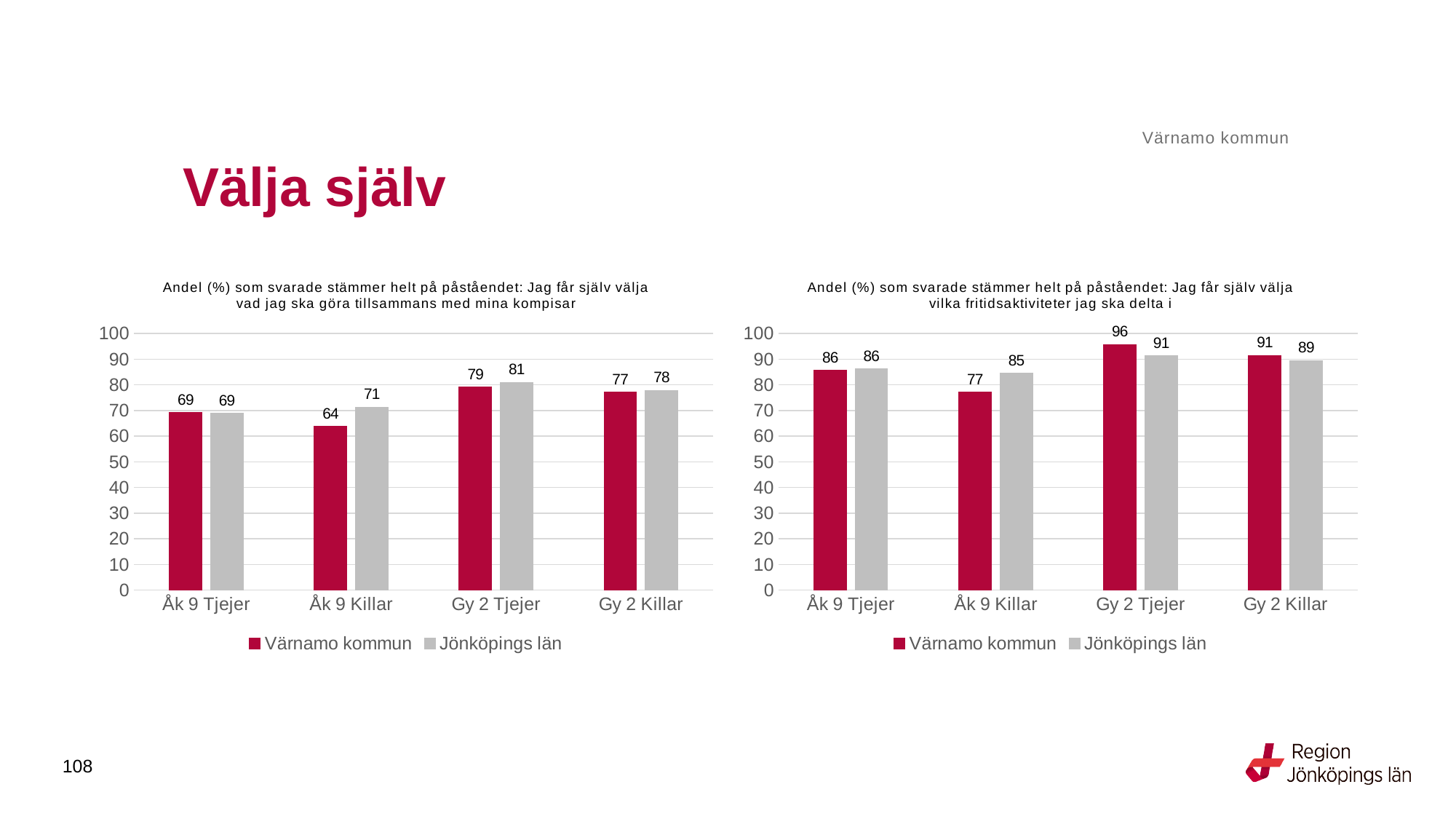
In the left chart (about choosing what to do with friends), what is the value for Jönköpings län for Gy 2 Tjejer? 81 In the left chart (about choosing what to do with friends), what is the value for Värnamo kommun for Åk 9 Killar? 64 What kind of chart is the left chart? Bar chart How many series does the legend of the right chart list? 2 In the right chart (about choosing leisure activities), what is the value for Värnamo kommun for Gy 2 Tjejer? 96 In the left chart (about choosing what to do with friends), which category has the lowest value for Värnamo kommun? Åk 9 Killar How many categories are shown on the x axis of the left chart? 4 In the right chart (about choosing leisure activities), what is the value for Jönköpings län for Åk 9 Killar? 85 In the right chart (about choosing leisure activities), which category has the highest value for Värnamo kommun? Gy 2 Tjejer In the right chart (about choosing leisure activities), which is larger for Åk 9 Killar: Värnamo kommun or Jönköpings län? Jönköpings län In the right chart (about choosing leisure activities), what is the difference between Värnamo kommun and Jönköpings län for Gy 2 Tjejer? 5 In the left chart (about choosing what to do with friends), what is the difference between Jönköpings län and Värnamo kommun for Åk 9 Killar? 7